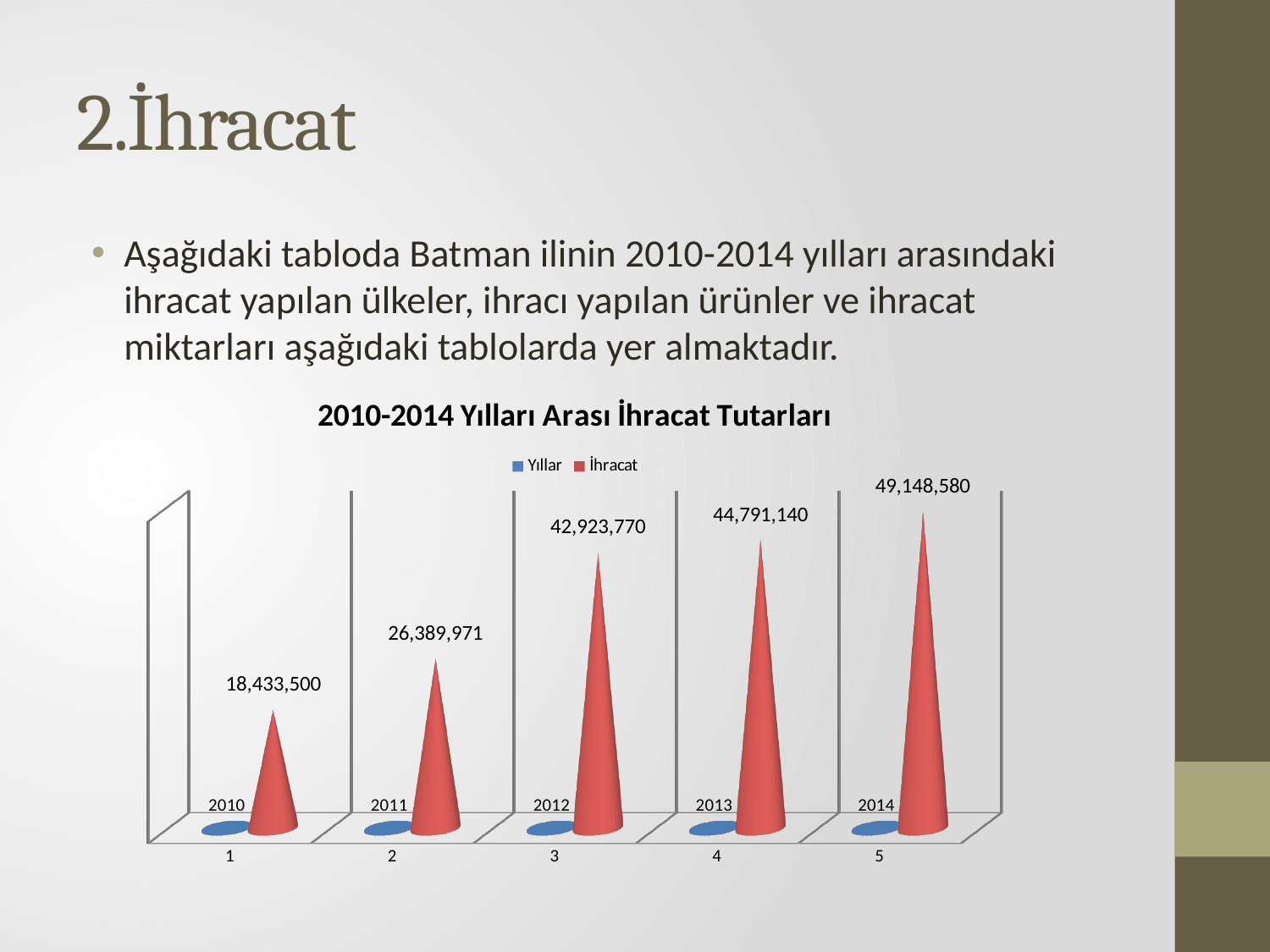
What is the difference between the İhracat values for 2013 and 2012? 1,867,370 Which year has the highest İhracat value? 2014 How many years are plotted in the chart? 5 What is the İhracat value for 2010? 18,433,500 Do the İhracat values rise or fall from 2010 to 2014? Rise Which year has the lowest İhracat value? 2010 Which year has a larger İhracat value, 2011 or 2012? 2012 What is the difference between the İhracat values for 2014 and 2010? 30,715,080 How many series does the legend list? 2 What is the İhracat value for 2014? 49,148,580 What is the İhracat value for 2012? 42,923,770 What kind of chart is shown on the slide? Bar chart